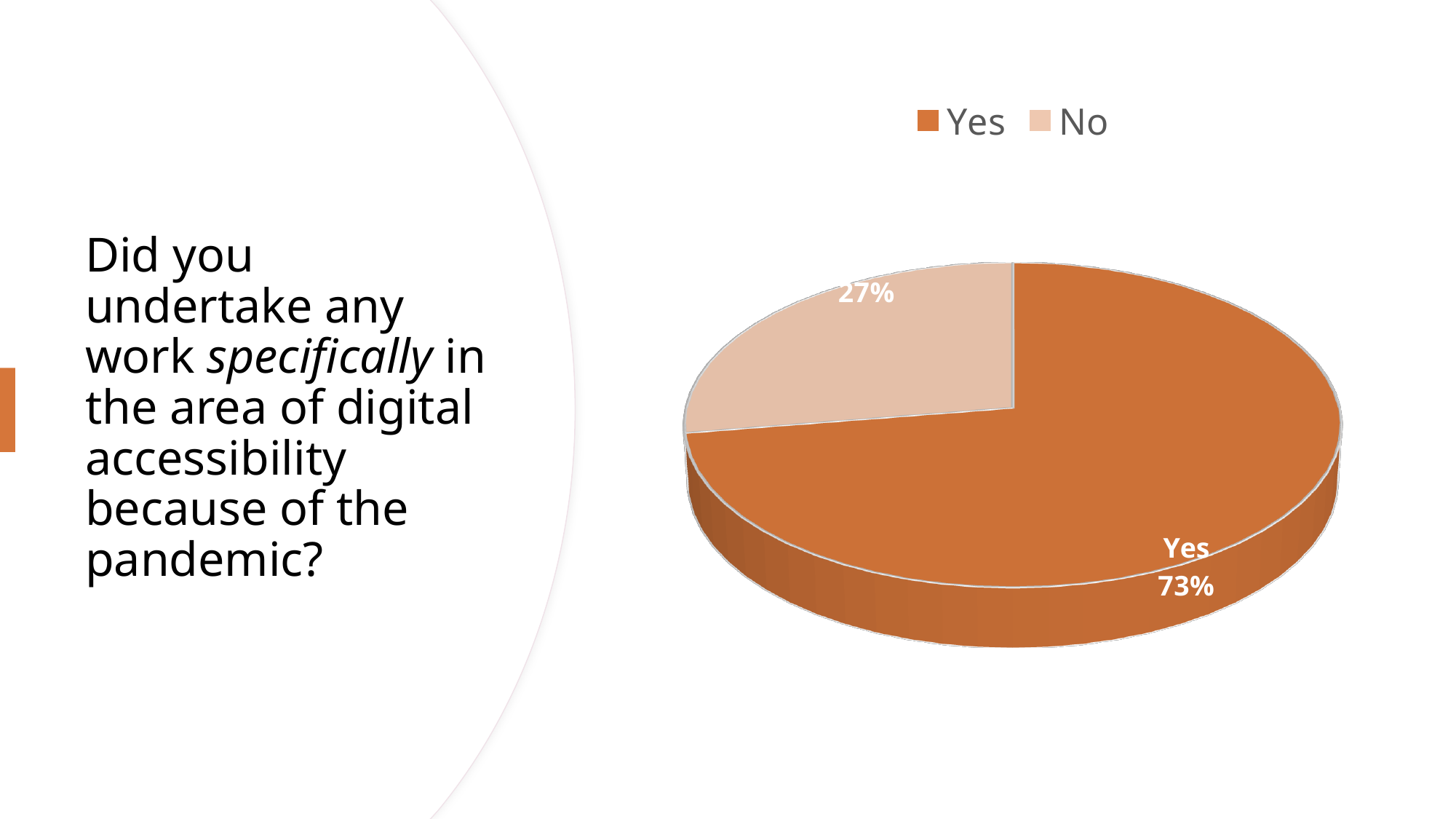
How many entries does the legend list? 2 What kind of chart is shown on the slide? pie chart What percentage of respondents answered No? 27% Which slice is larger, Yes or No? Yes What share of the pie does the No slice represent? 27% How many slices does the pie chart have? 2 What question does the pie chart answer, according to the text on the slide? Did you undertake any work specifically in the area of digital accessibility because of the pandemic? Which legend entry is shown in the darker orange colour? Yes Which response has the largest share of the pie? Yes What percentage of respondents answered Yes? 73% Which response has the smallest share of the pie? No What is the difference in percentage points between the Yes and No slices? 46